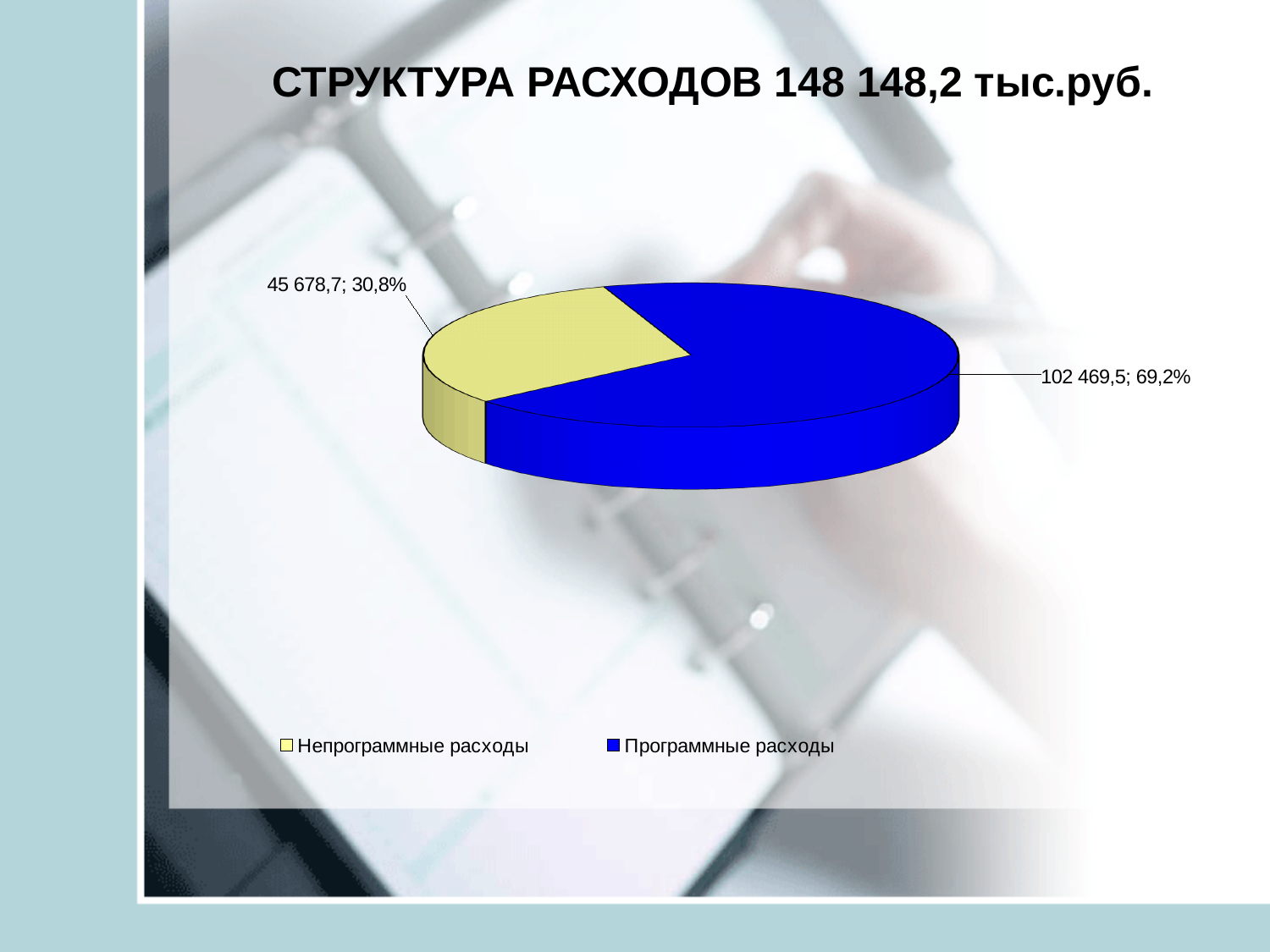
What is the difference between the values for Программные расходы and Непрограммные расходы? 56 790,8 What kind of chart is shown on the slide? pie chart What share of the pie does Программные расходы take? 69,2% What is the value for Непрограммные расходы? 45 678,7 Which category has the largest slice of the pie? Программные расходы What colour is the slice for Программные расходы? blue What share of the pie does Непрограммные расходы take? 30,8% Which category has the smallest slice of the pie? Непрограммные расходы What is the title of the chart on the slide? СТРУКТУРА РАСХОДОВ 148 148,2 тыс.руб. How many slices does the pie chart have? 2 Which is larger, Программные расходы or Непрограммные расходы? Программные расходы What is the value for Программные расходы? 102 469,5